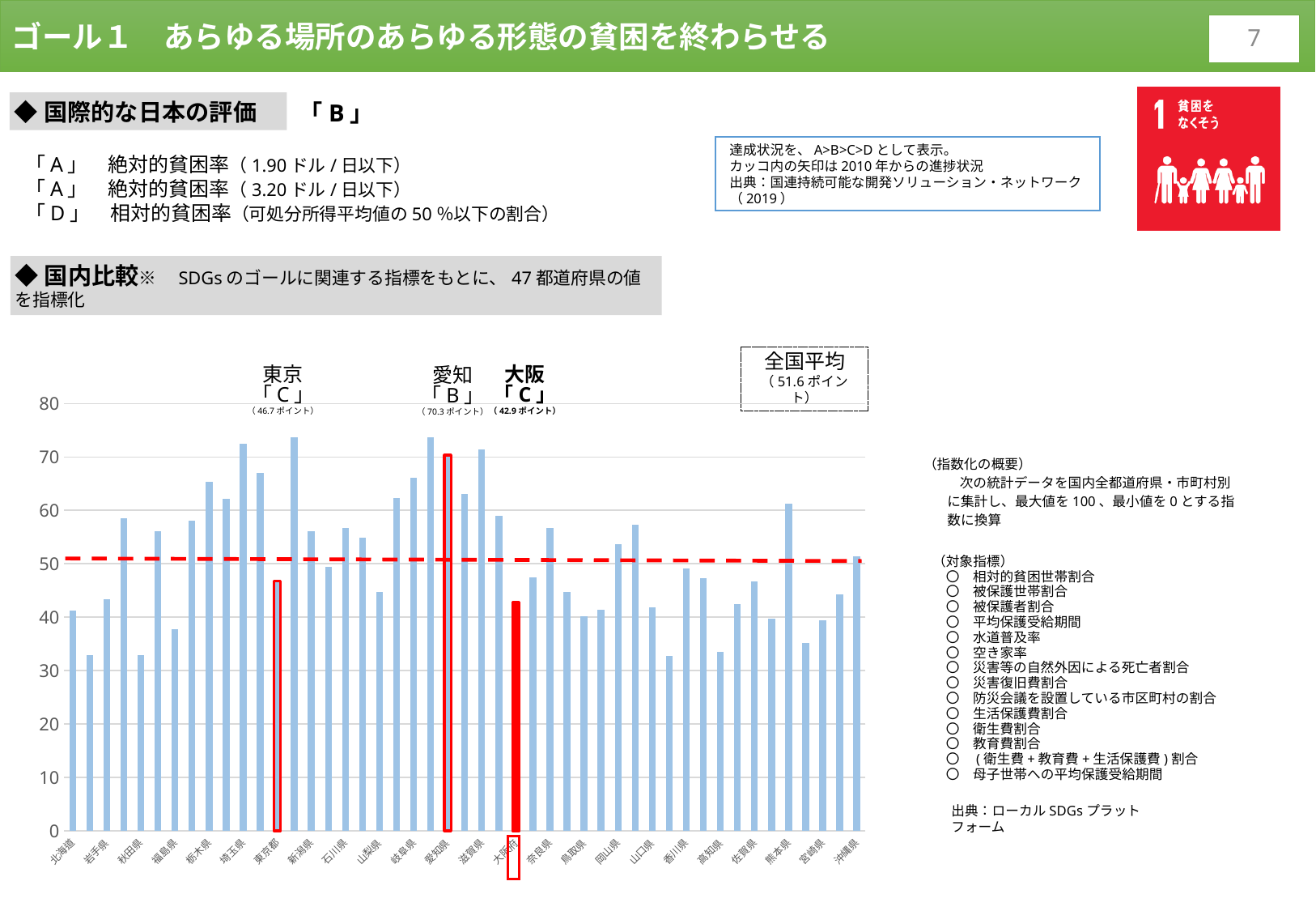
What is the difference between the values for 東京 and 大阪? 3.8 ポイント What is the value shown for 大阪 (Osaka) on the chart? 42.9 ポイント What is the 全国平均 (national average) value shown on the chart? 51.6 ポイント What is the value shown for 東京 (Tokyo) on the chart? 46.7 ポイント What does the red dashed horizontal line on the chart represent? 全国平均 (51.6 ポイント) What is the difference between the values for 愛知 and 東京? 23.6 ポイント What is the value shown for 愛知 (Aichi) on the chart? 70.3 ポイント Which has the larger value, 愛知 or 大阪? 愛知 Is the value for 岐阜県 greater or less than 60? greater Is the value for 岩手県 greater or less than 40? greater Is the value for 北海道 greater or less than 50? less What kind of chart is shown on the slide? bar chart